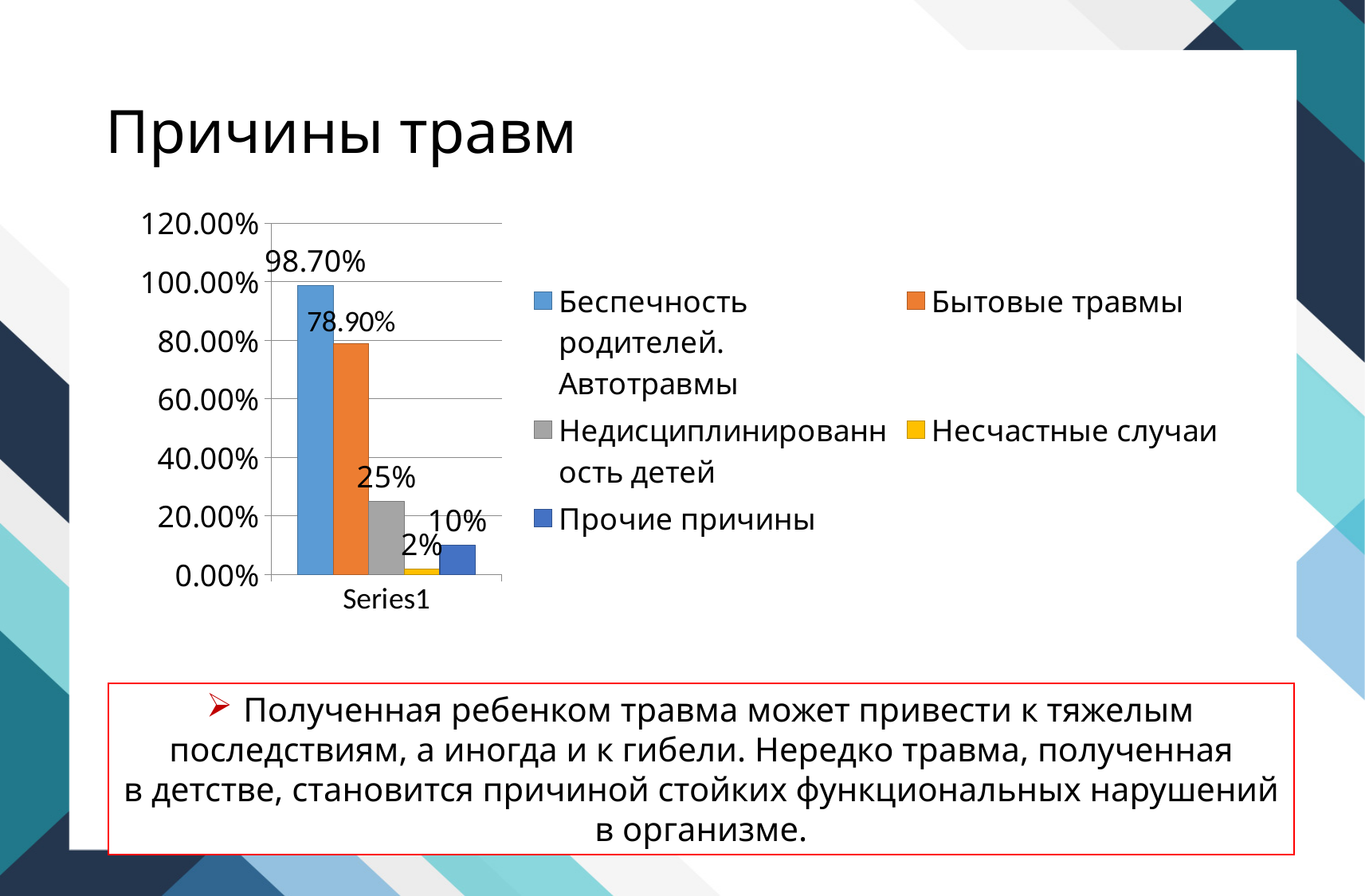
What value is shown for Недисциплинированность детей? 25% What is the title of the slide containing the chart? Причины травм Which is larger, the value for Прочие причины or the value for Несчастные случаи? Прочие причины What value is shown for Прочие причины? 10% What is the difference between the values for Беспечность родителей. Автотравмы and Бытовые травмы? 19.80% What value is shown for Несчастные случаи? 2% What kind of chart is shown on the slide? Bar chart What value is shown for Бытовые травмы? 78.90% Which series has the highest value? Беспечность родителей. Автотравмы What value is shown for Беспечность родителей. Автотравмы? 98.70% How many series does the legend list? 5 Which series has the lowest value? Несчастные случаи